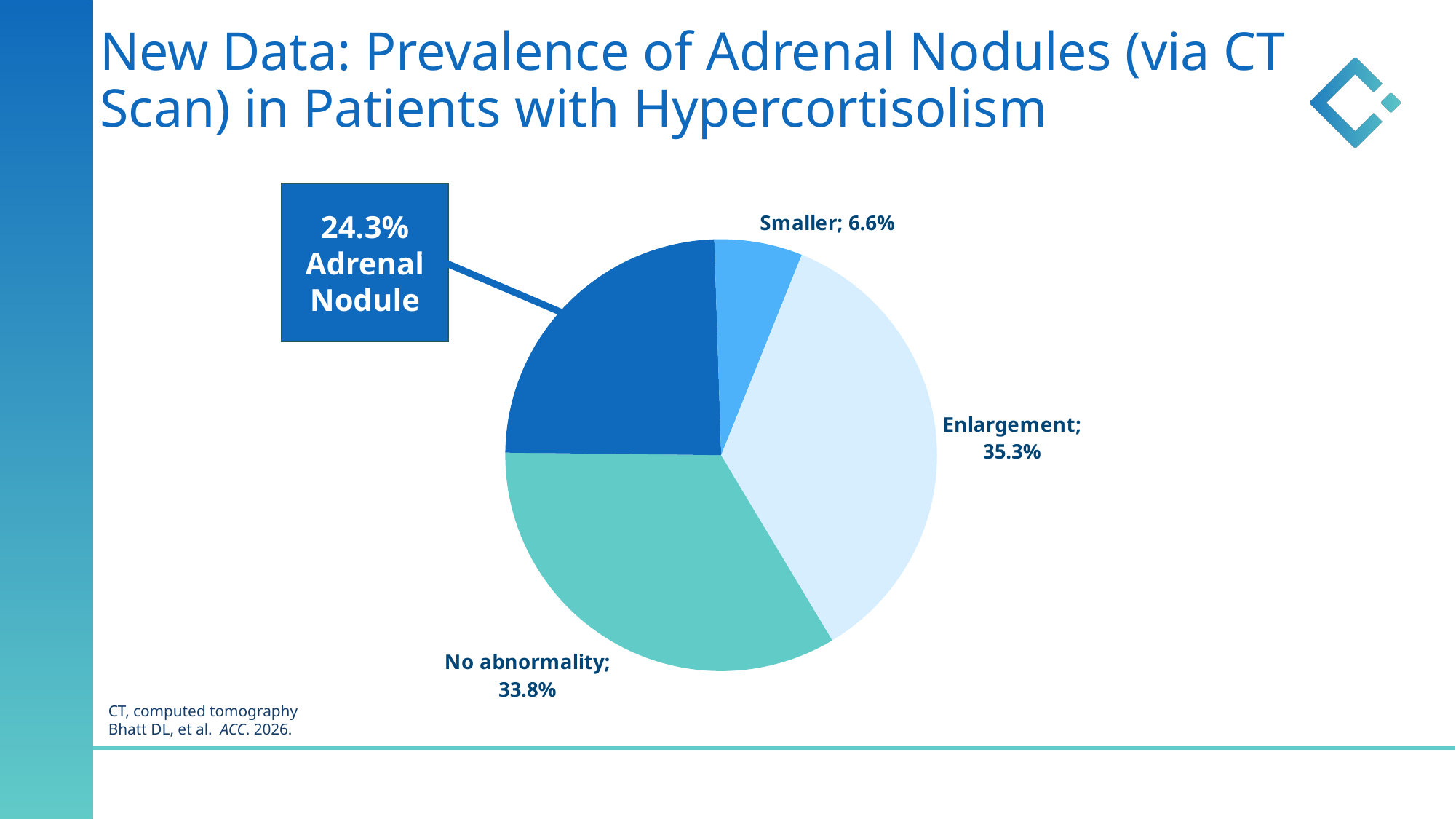
What is the value for the Enlargement slice? 35.3% Which is larger, the Adrenal Nodule slice or the Smaller slice? Adrenal Nodule What kind of chart is shown on the slide? pie chart What percentage of patients had an adrenal nodule? 24.3% Which category has the largest share of the pie? Enlargement What is the difference between the Enlargement and No abnormality percentages? 1.5% What is the value for the Smaller slice? 6.6% Which category has the smallest share of the pie? Smaller What is the title of the slide containing the chart? New Data: Prevalence of Adrenal Nodules (via CT Scan) in Patients with Hypercortisolism How many slices does the pie chart have? 4 What is the value for the No abnormality slice? 33.8% What is the difference between the Adrenal Nodule and Smaller percentages? 17.7%